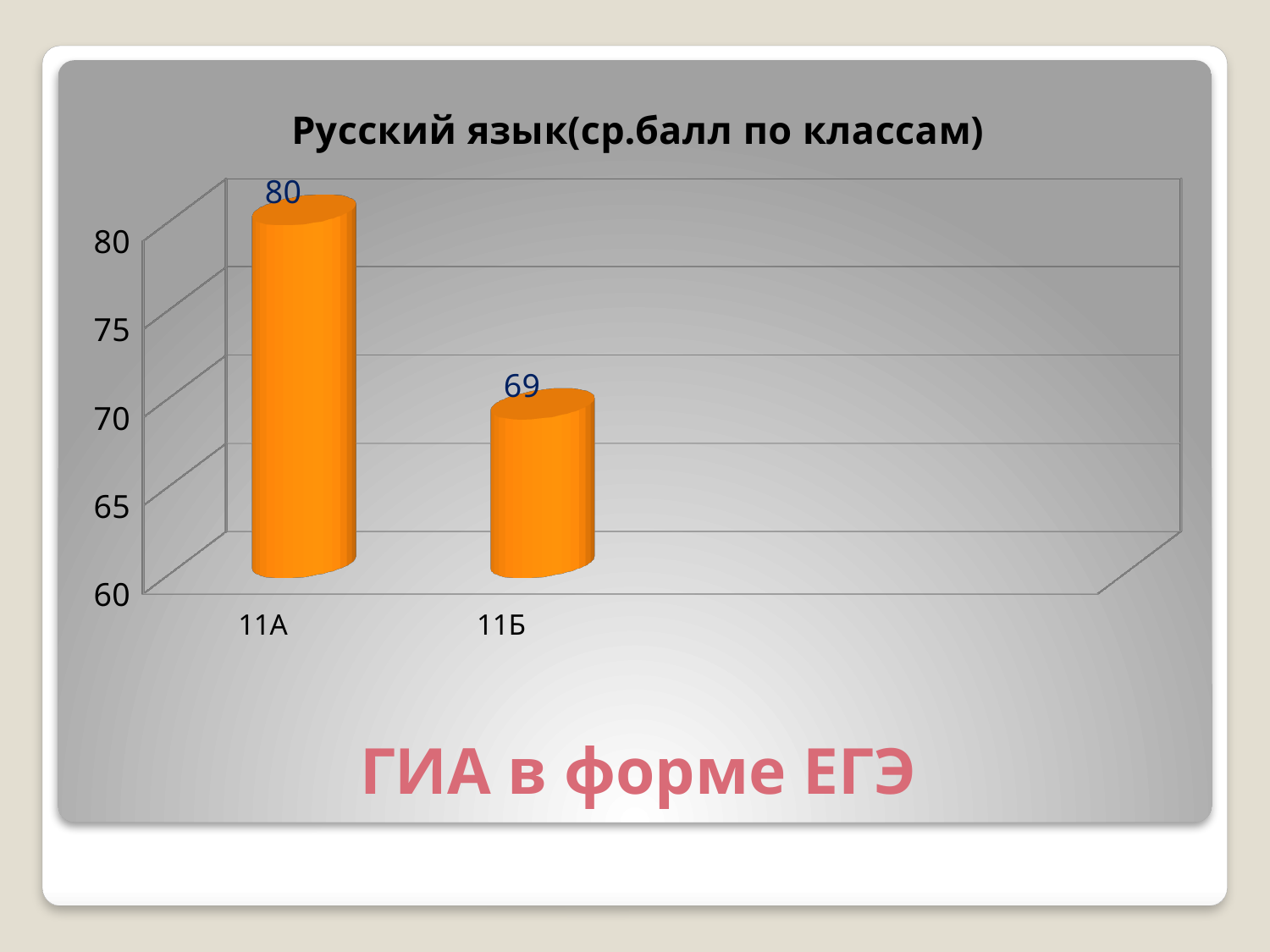
What is the difference between the average scores of 11А and 11Б? 11 Which class has the lowest average score? 11Б Is the value for 11А greater or less than 75? greater What colour are the bars in the chart? orange Which class has the highest average score? 11А Is the value for 11Б greater or less than 70? less How many classes are shown in the chart? 2 What kind of chart is shown on the slide? bar chart What is the title of the chart? Русский язык(ср.балл по классам) Which class has the larger average score, 11А or 11Б? 11А What is the average score for class 11Б? 69 What is the average score for class 11А? 80